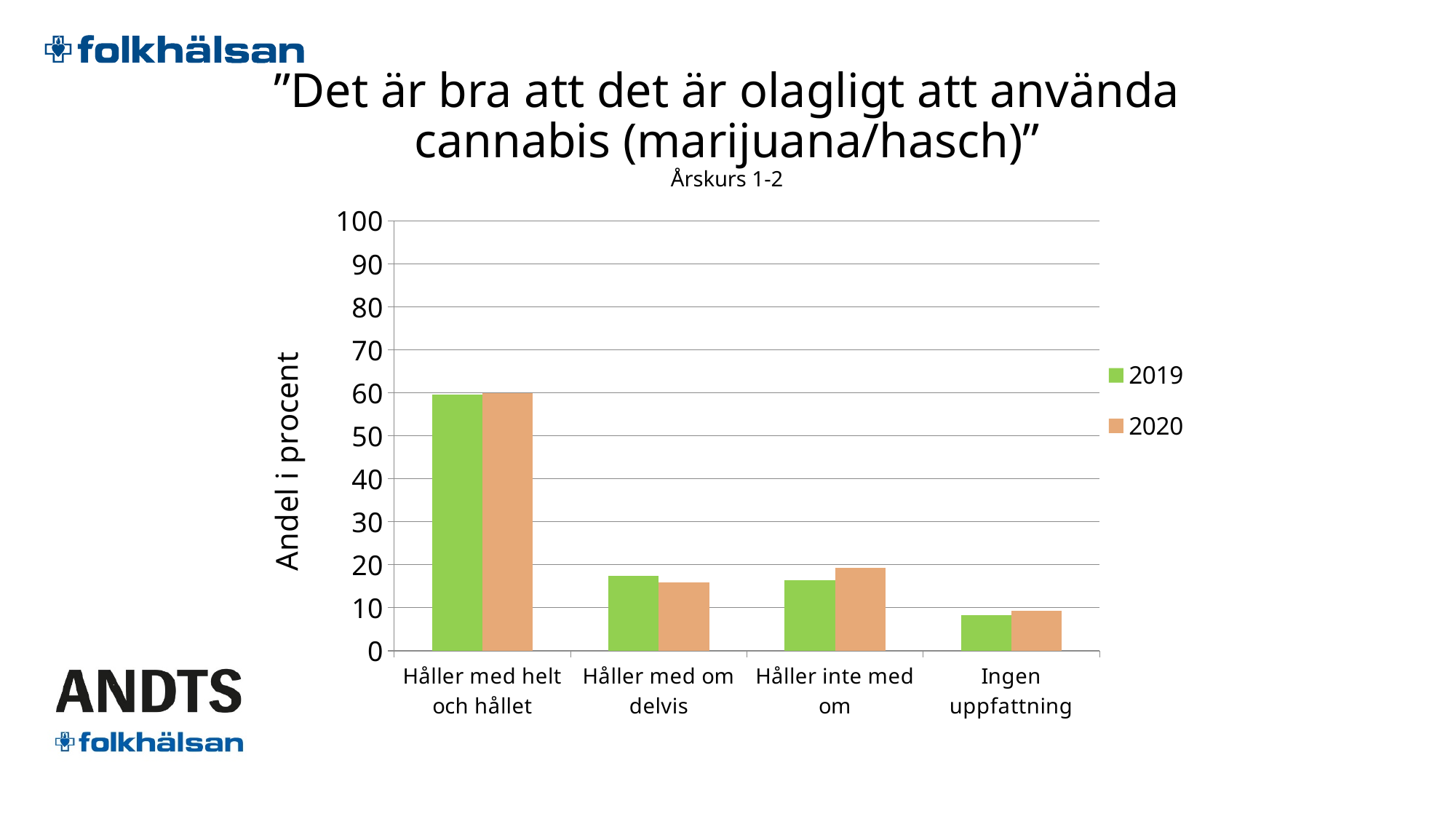
Is the 2020 value for Håller inte med om greater or less than 10? greater For Håller inte med om, which year has the larger value, 2019 or 2020? 2020 Which colour represents the 2019 series in the legend? green Which category has the lowest value for 2019? Ingen uppfattning Is the 2019 value for Håller med helt och hållet greater or less than 50? greater Is the 2020 value for Håller med om delvis greater or less than 20? less What is the label of the y axis? Andel i procent How many series does the legend list? 2 What kind of chart is shown on the slide? bar chart How many categories are shown on the x axis of the chart? 4 Which category has the highest value for 2020? Håller med helt och hållet